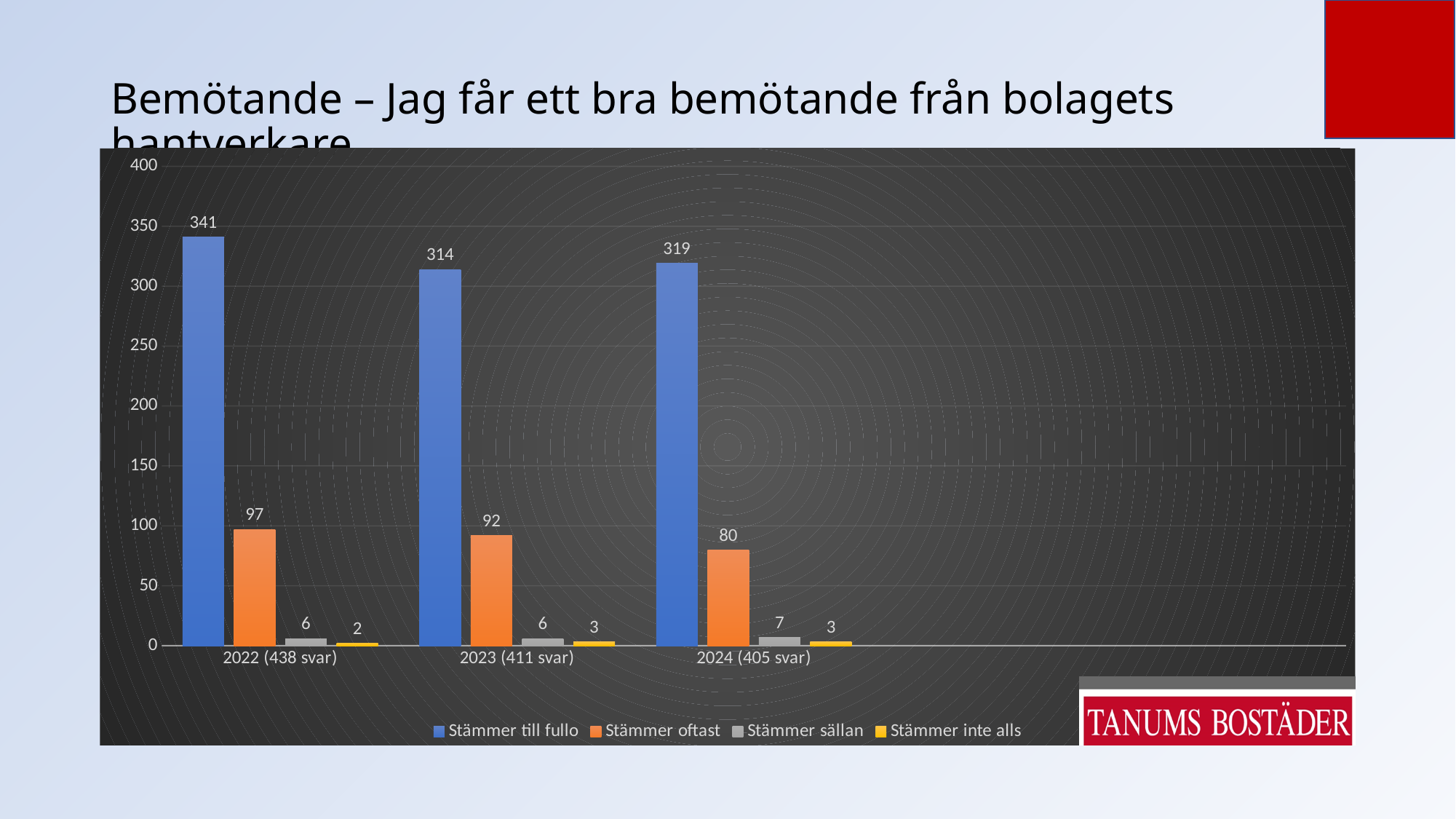
Which colour represents "Stämmer inte alls" in the legend? Yellow What is the value for "Stämmer oftast" in 2024 (405 svar)? 80 What is the value for "Stämmer inte alls" in 2022 (438 svar)? 2 What is the difference between the "Stämmer till fullo" values for 2022 (438 svar) and 2023 (411 svar)? 27 What is the value for "Stämmer till fullo" in 2022 (438 svar)? 341 How many series does the legend list? 4 In which year is the value for "Stämmer oftast" lowest? 2024 (405 svar) What kind of chart is shown on the slide? Bar chart Which is larger: "Stämmer oftast" in 2022 (438 svar) or in 2023 (411 svar)? 2022 (438 svar) What is the value for "Stämmer sällan" in 2023 (411 svar)? 6 In which year is the value for "Stämmer till fullo" highest? 2022 (438 svar) How many year categories are shown on the x axis? 3